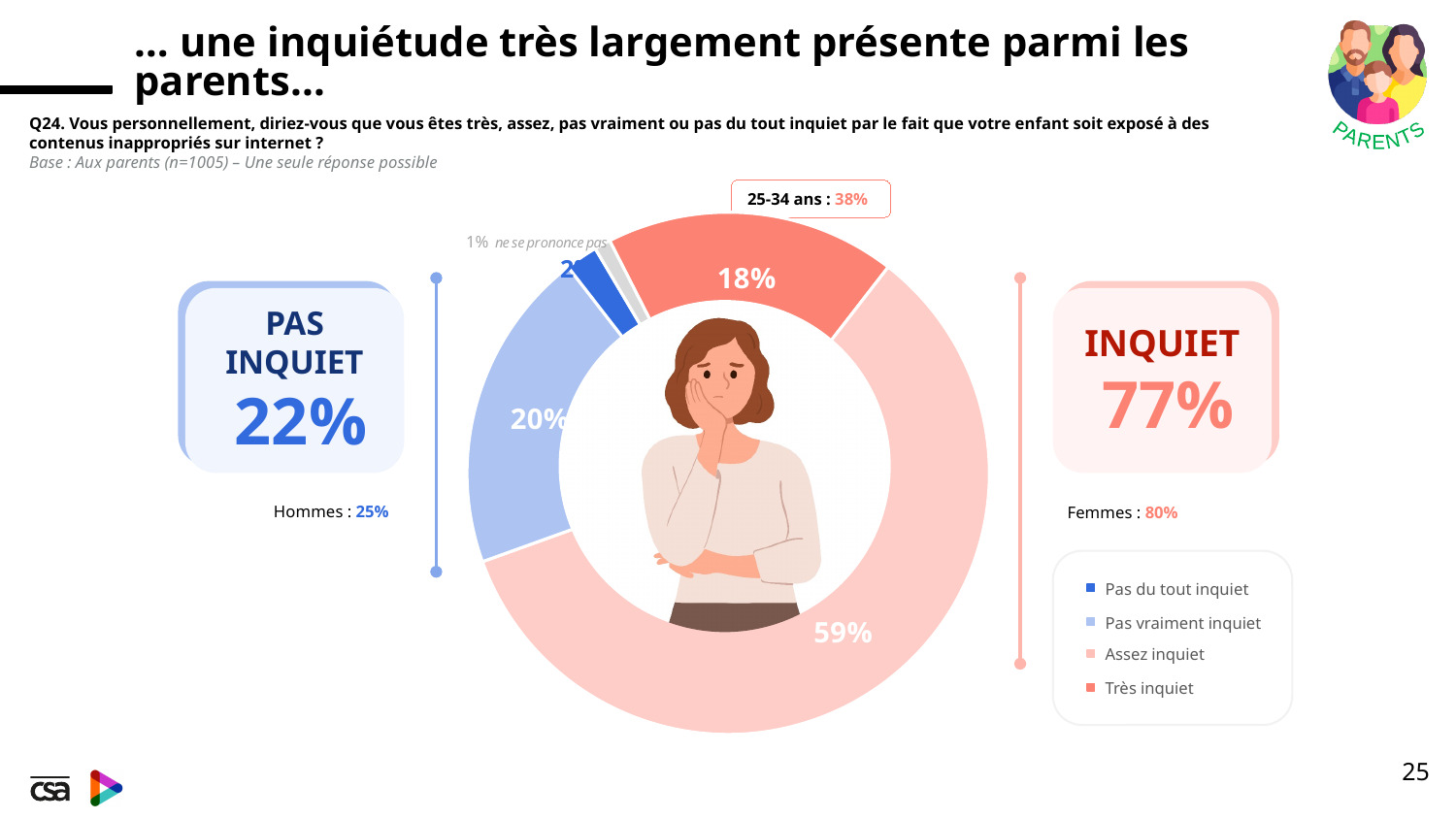
What share of parents answered "Assez inquiet"? 59% What is the combined share of parents who are "Inquiet" according to the slide? 77% What share of parents answered "Pas vraiment inquiet"? 20% Which response category has the largest slice of the donut? Assez inquiet What is the difference between the "Assez inquiet" share and the "Très inquiet" share? 41 points What percentage of parents did not give an answer ("ne se prononce pas")? 1% Which of the legend categories has the smallest slice of the donut? Pas du tout inquiet What share of parents answered "Très inquiet"? 18% What percentage of women (Femmes) are reported as worried on the slide? 80% What kind of chart is shown on the slide? Pie chart (donut) How many categories does the legend list? 4 Which is larger: the share for "Pas vraiment inquiet" or the share for "Très inquiet"? Pas vraiment inquiet